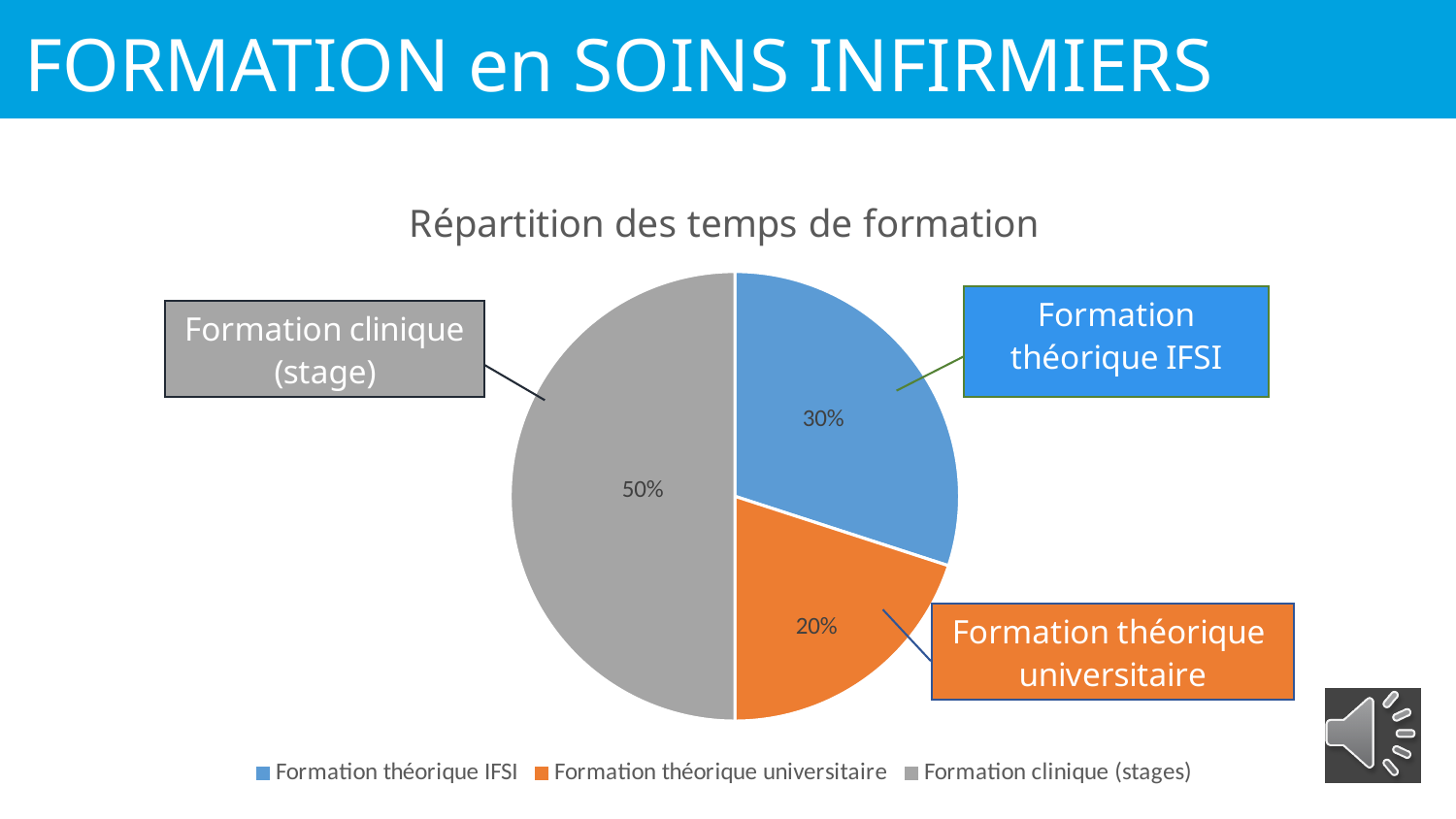
Which category has the smallest slice of the pie? Formation théorique universitaire What is the title of the chart? Répartition des temps de formation How many categories are shown in the pie chart? 3 What is the value shown for Formation théorique IFSI? 30% Which category has the largest slice of the pie? Formation clinique (stages) What is the value shown for Formation théorique universitaire? 20% What is the difference between the Formation clinique (stages) share and the Formation théorique IFSI share? 20% What kind of chart is shown on the slide? Pie chart What share of the pie does Formation clinique (stages) take? 50% What colour is the slice for Formation théorique universitaire? Orange Which is larger, the share for Formation théorique IFSI or for Formation théorique universitaire? Formation théorique IFSI What is the difference between the Formation théorique IFSI share and the Formation théorique universitaire share? 10%